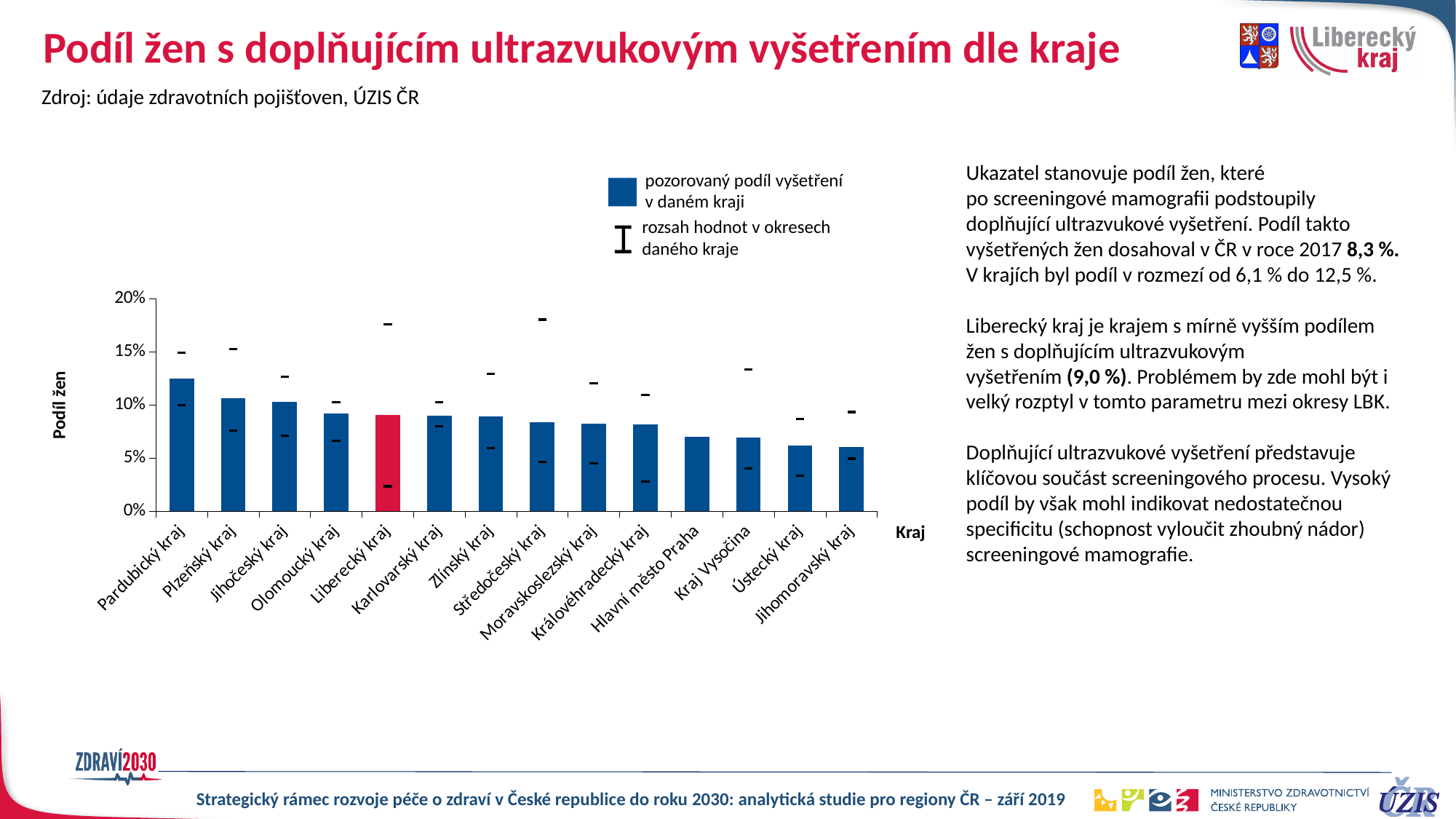
Is the value for Hlavní město Praha greater or less than 10%? less Is the value for Liberecký kraj greater or less than 10%? less Is the value for Pardubický kraj greater or less than 10%? greater What kind of chart is shown on the slide? bar chart Which region's bar is highlighted in red in the chart? Liberecký kraj What is the label of the vertical axis of the chart? Podíl žen Do the bar values rise or fall from left to right along the x axis? fall Which has a higher value, Karlovarský kraj or Hlavní město Praha? Karlovarský kraj How many regions (kraje) are shown on the x axis of the chart? 14 Which region has the highest observed share of women with a supplementary ultrasound examination? Pardubický kraj Which has a higher value, Pardubický kraj or Plzeňský kraj? Pardubický kraj